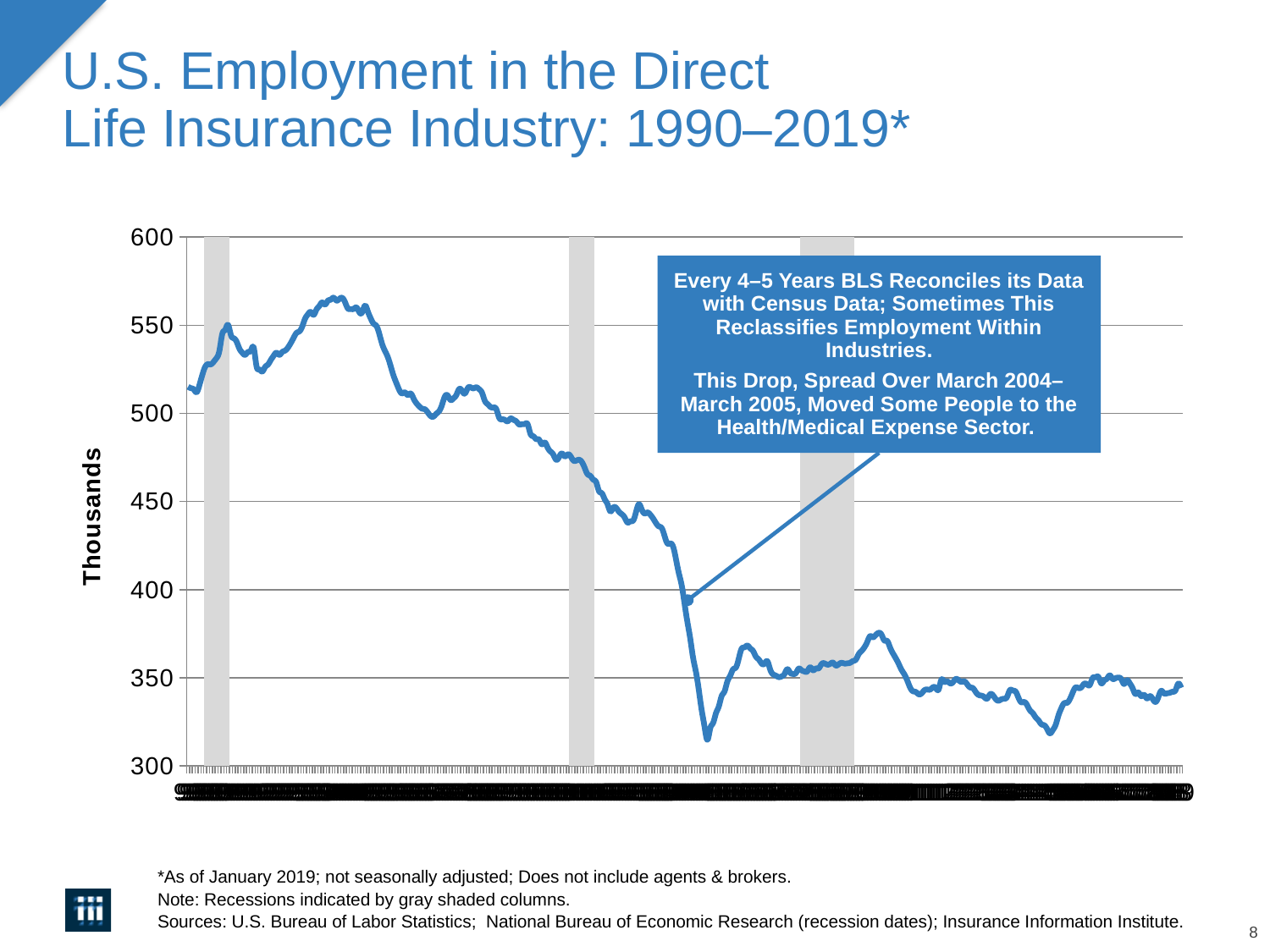
What kind of chart is shown on the slide? Line chart Is the value at the far right (end) of the line greater or less than 400? less Is the value at the far left of the line greater or less than the value at the far right of the line? greater Is the value at the far left (start) of the line greater or less than 500? greater What is the lowest value shown on the vertical axis? 300 Does the highest point of the line occur in the left half or the right half of the chart? Left half Is the lowest point of the line greater or less than 350? less What is the title of the chart on the slide? U.S. Employment in the Direct Life Insurance Industry: 1990–2019* How many gray shaded recession columns are shown on the chart? 3 What is the label on the vertical axis of the chart? Thousands Overall, do the values rise or fall from left to right along the x axis? Fall